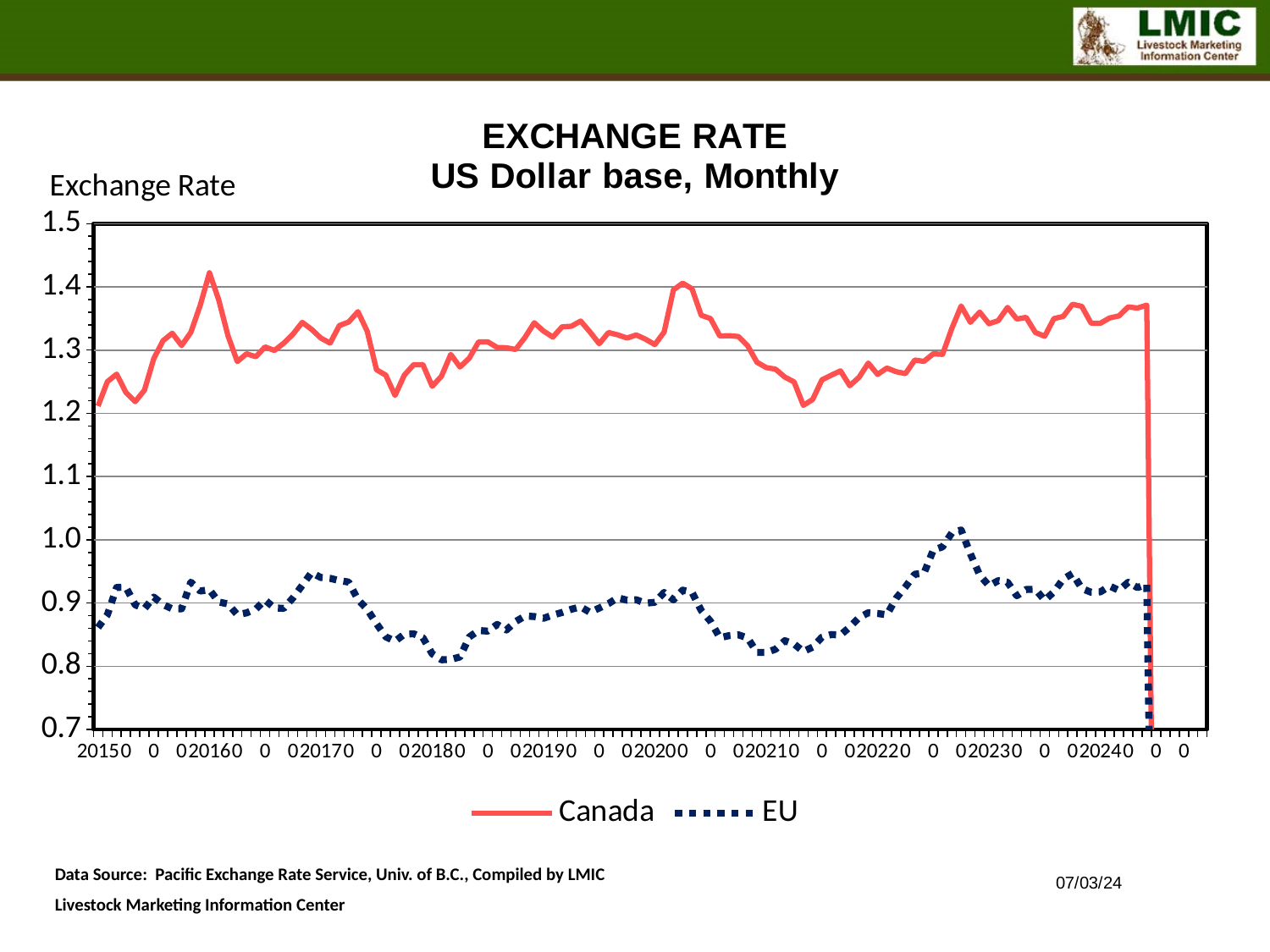
Is the highest value of the EU line greater or less than 0.9? greater Which series is plotted with a dashed line? EU What is the highest value shown on the vertical axis? 1.5 What type of chart is shown on the slide? Line chart What is the lowest value shown on the vertical axis? 0.7 Which series has the higher values across the chart, Canada or EU? Canada Is the EU line ever greater than 1.1 on the chart? No How many series does the legend list? 2 Is the highest value of the Canada line greater or less than 1.3? greater